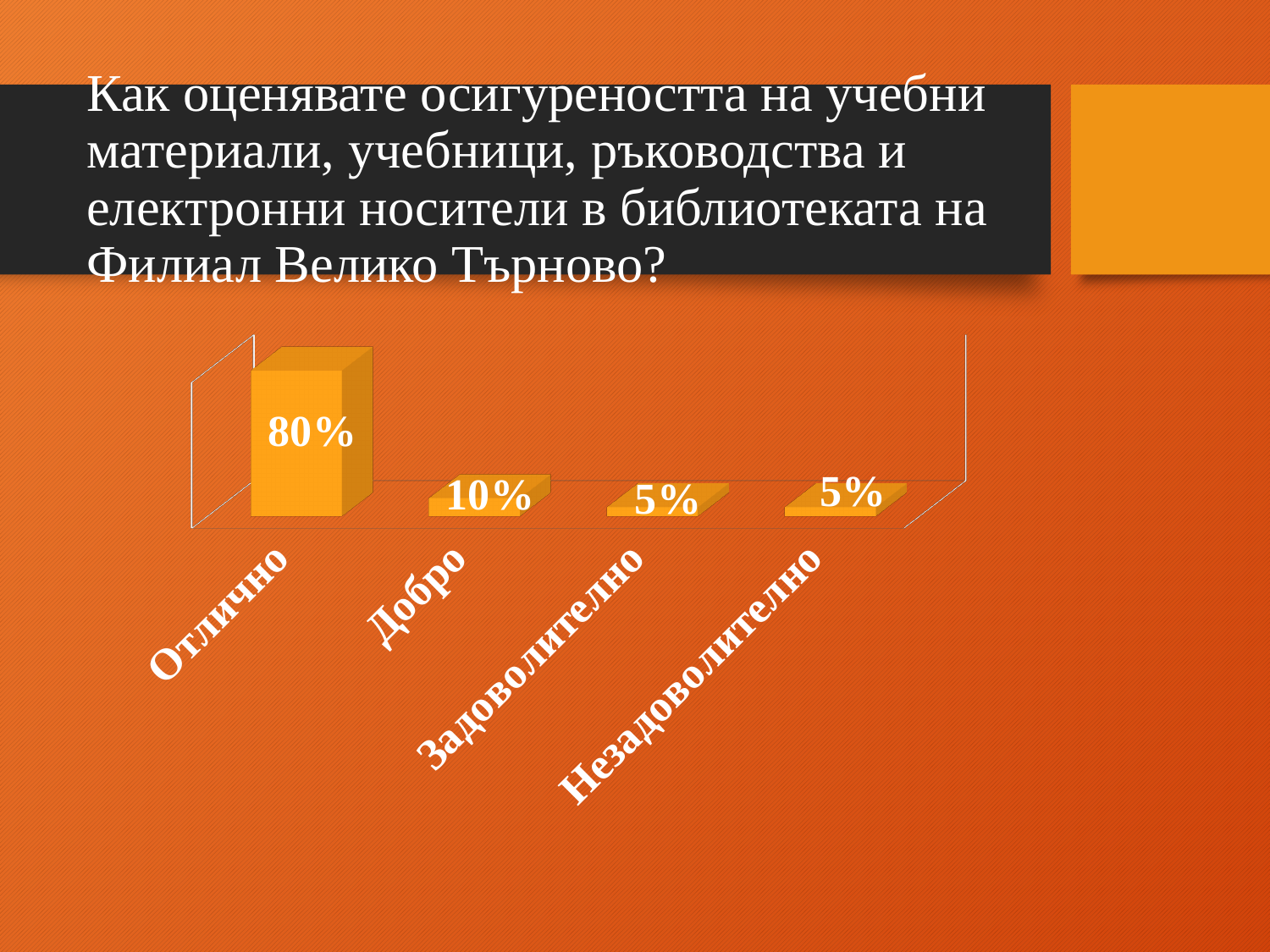
Do the values rise or fall from left to right along the x axis? fall What is the difference between the values for Отлично and Добро? 70% Which is larger, the value for Отлично or the value for Добро? Отлично How many categories are shown on the chart? 4 What is the total of the values for Задоволително and Незадоволително? 10% What is the value for Добро? 10% What is the value for Отлично? 80% What is the value for Задоволително? 5% What kind of chart is shown on the slide? bar chart What is the value for Незадоволително? 5% Which category has the highest value? Отлично What is the difference between the values for Добро and Задоволително? 5%